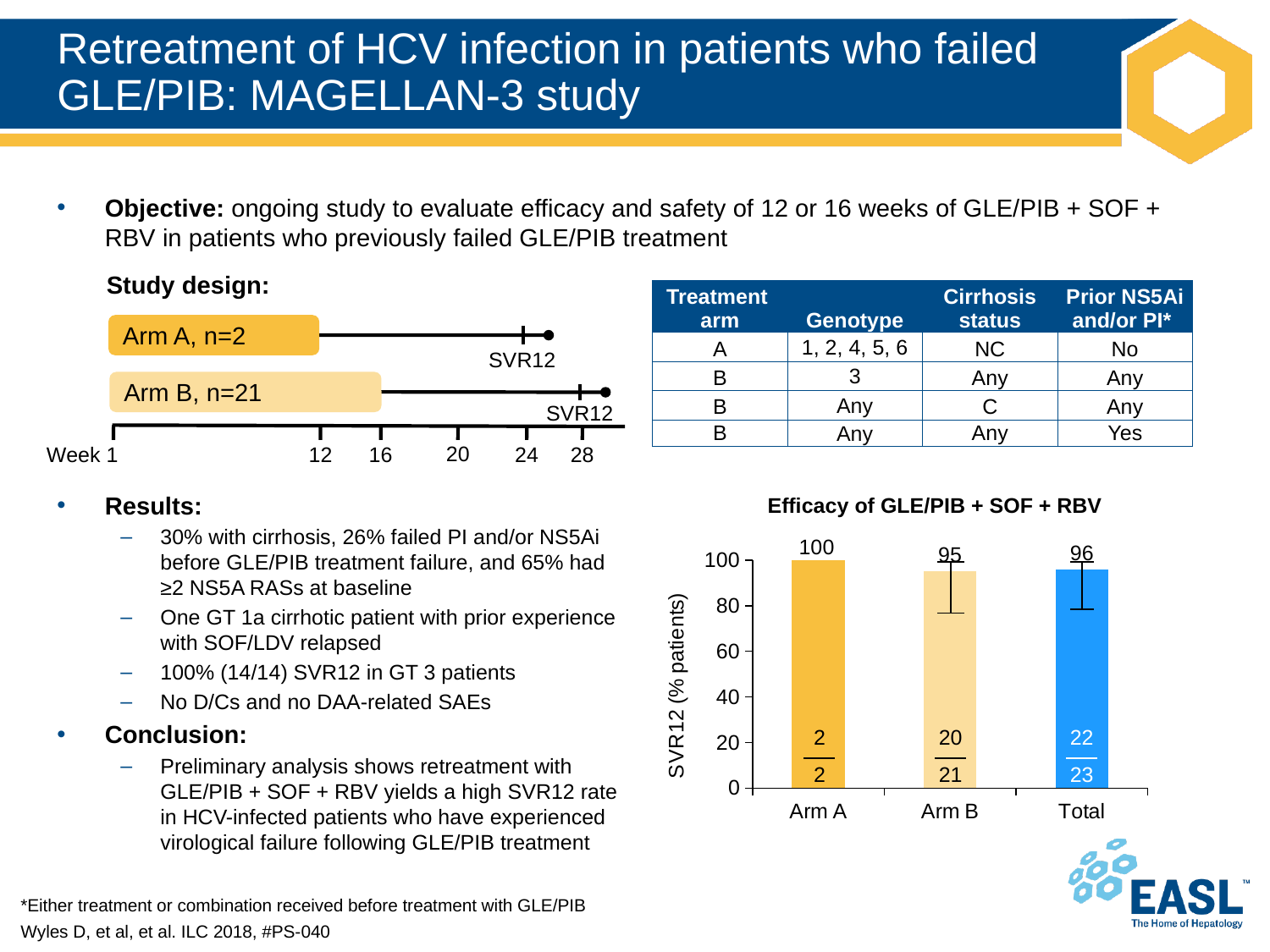
Is the SVR12 rate for Arm A or for Total larger? Arm A What fraction of patients is printed on the Total bar? 22/23 What is the SVR12 rate shown for Arm B in the chart? 95 What is the SVR12 rate shown for Arm A in the Efficacy of GLE/PIB + SOF + RBV chart? 100 Which category has the lowest SVR12 rate in the chart? Arm B Which category has the highest SVR12 rate in the chart? Arm A What fraction of patients is printed on the Arm B bar? 20/21 How many categories are shown on the x axis of the chart? 3 What kind of chart is the Efficacy of GLE/PIB + SOF + RBV chart? Bar chart What is the y-axis label of the chart? SVR12 (% patients) What is the difference between the SVR12 rates for Arm A and Arm B? 5 What is the SVR12 rate shown for Total in the chart? 96